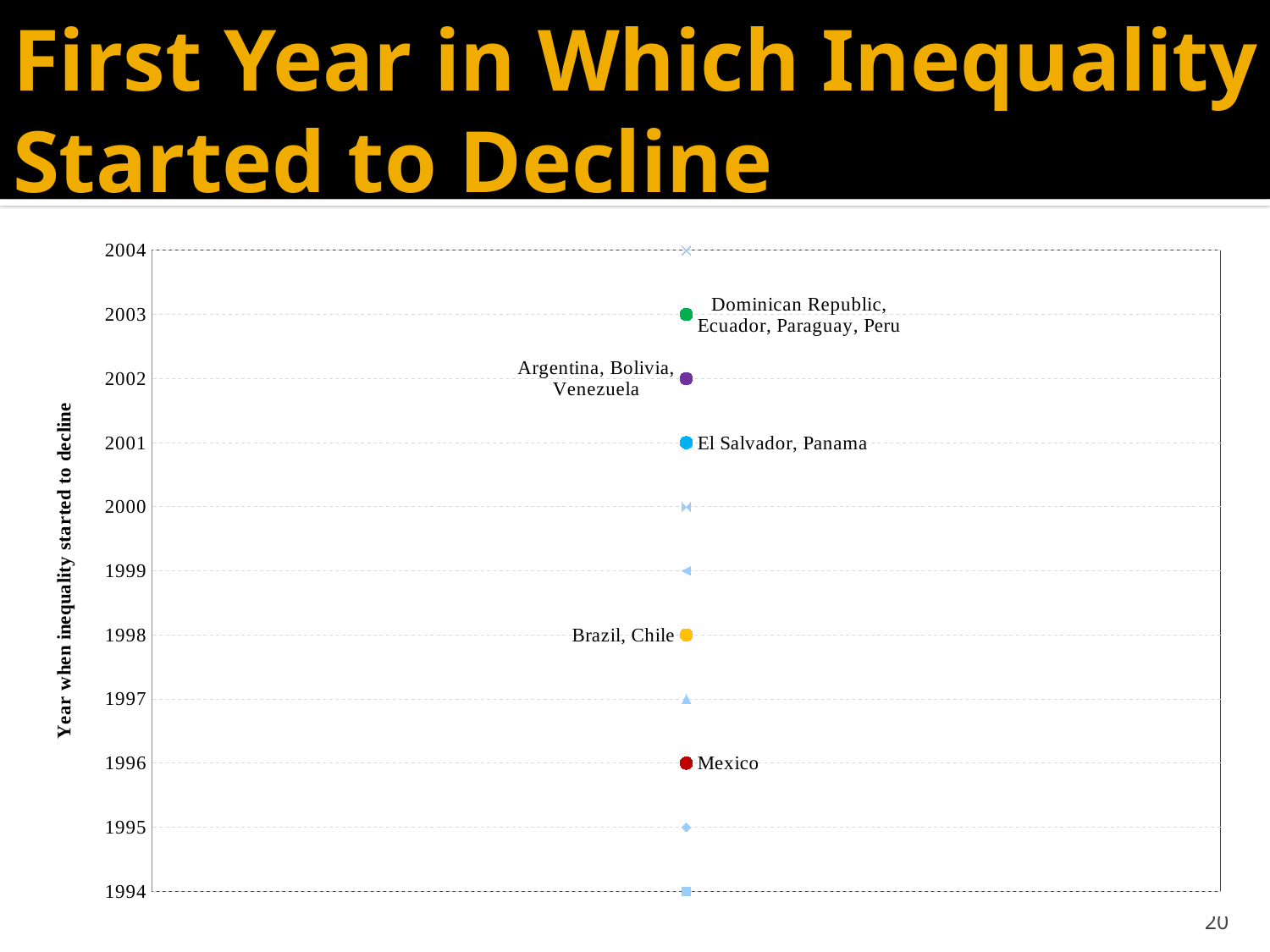
In which year did inequality start to decline in El Salvador and Panama? 2001 What year is shown for Argentina, Bolivia and Venezuela? 2002 Which labelled country group has the earliest year in which inequality started to decline? Mexico How many labelled country groups are shown on the chart? 5 What kind of chart is shown on the slide? Scatter chart Did inequality start to decline earlier in Mexico or in Brazil and Chile? Mexico What year is plotted for Brazil and Chile? 1998 In which year did inequality start to decline in the Dominican Republic, Ecuador, Paraguay and Peru? 2003 In what year did inequality start to decline in Mexico, according to the chart? 1996 How many years separate the start of the decline in Mexico from the start in the Dominican Republic, Ecuador, Paraguay and Peru? 7 What is the title of the vertical axis? Year when inequality started to decline Which labelled country group has the latest year in which inequality started to decline? Dominican Republic, Ecuador, Paraguay, Peru